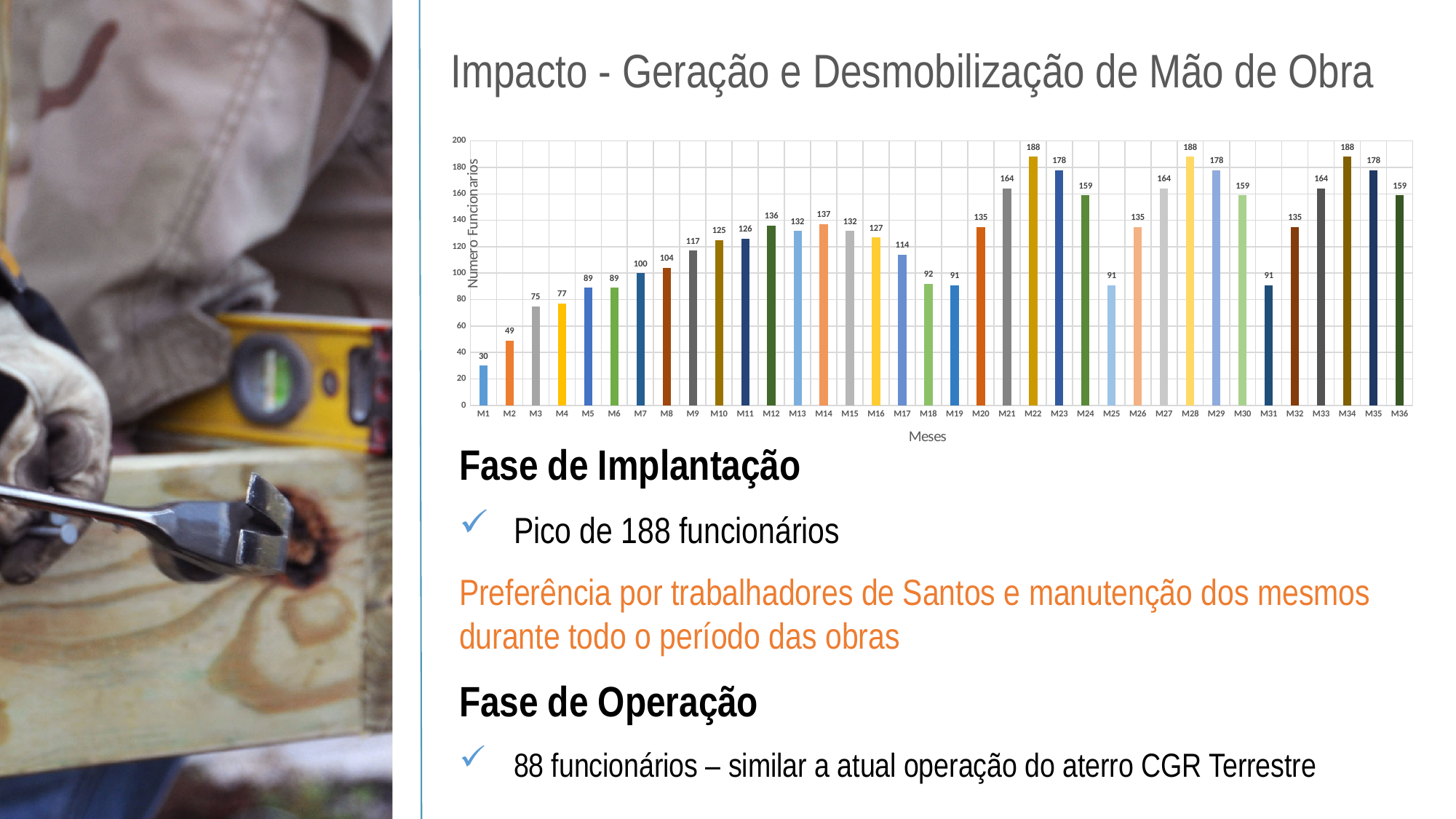
Do the values rise or fall from M1 to M12? rise Which month has the lowest value in the chart? M1 What is the value for M17 in the chart? 114 What is the difference between the values for M22 and M21? 24 What is the value for M1 in the chart? 30 What is the highest value shown in the chart? 188 What is the value for M22 in the chart? 188 What is the title of the vertical axis of the chart? Numero Funcionarios Is the value for M25 greater or less than 100? less How many months (categories) are plotted on the x axis of the chart? 36 What type of chart is shown on the slide? bar chart Which is larger, the value for M14 or the value for M13? M14